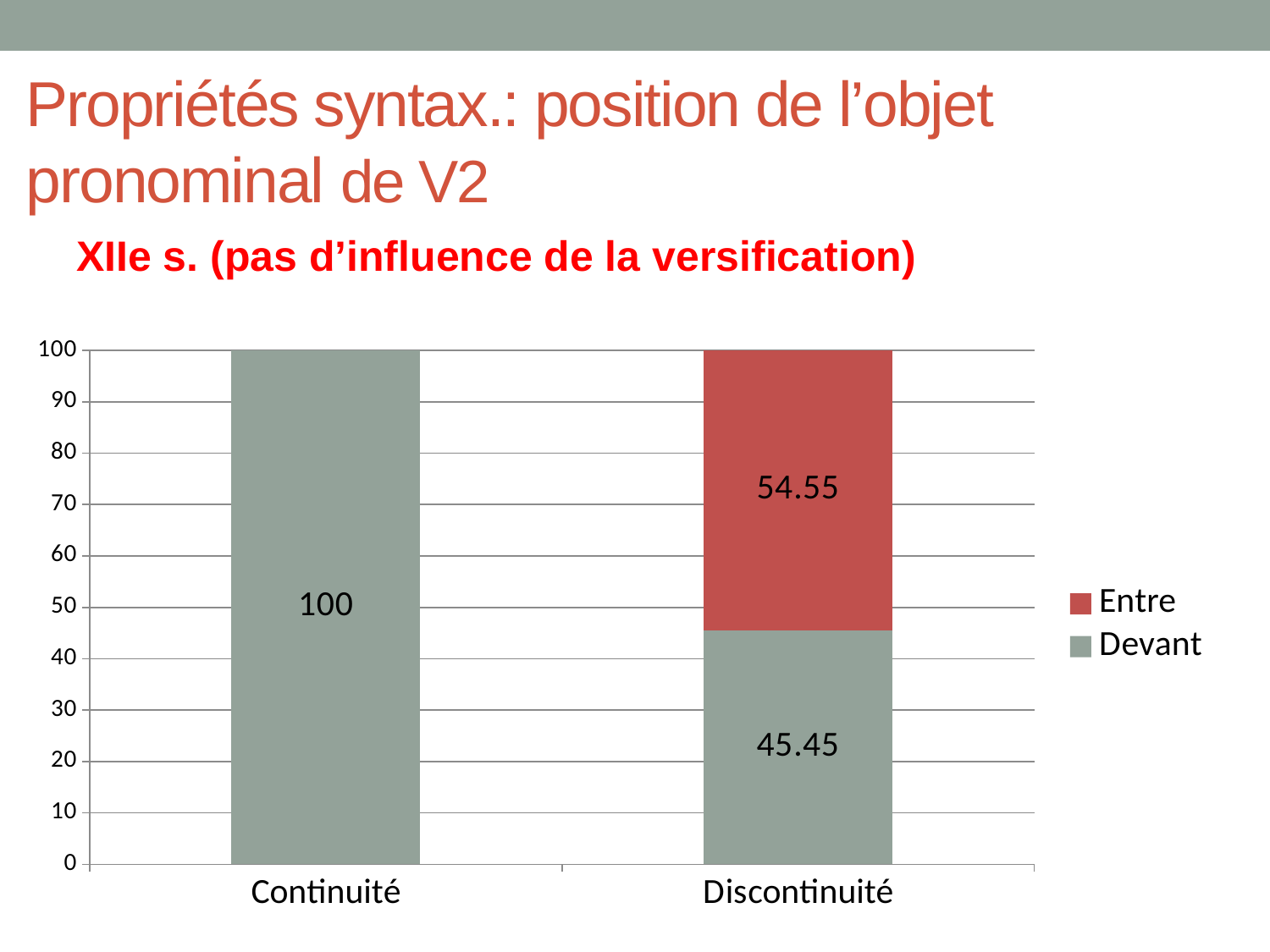
What kind of chart is shown on the slide? Stacked bar chart How many series does the legend list? 2 What is the total of the stacked bar for Discontinuité? 100 For Discontinuité, which is larger, Entre or Devant? Entre How many categories are shown on the x axis? 2 What is the value of Devant for Continuité? 100 Which series is shown in red? Entre What is the red subtitle above the chart? XIIe s. (pas d’influence de la versification) What is the value of Devant for Discontinuité? 45.45 Which category has the higher Devant value? Continuité What is the value of Entre for Discontinuité? 54.55 What is the difference between the Entre and Devant values for Discontinuité? 9.1